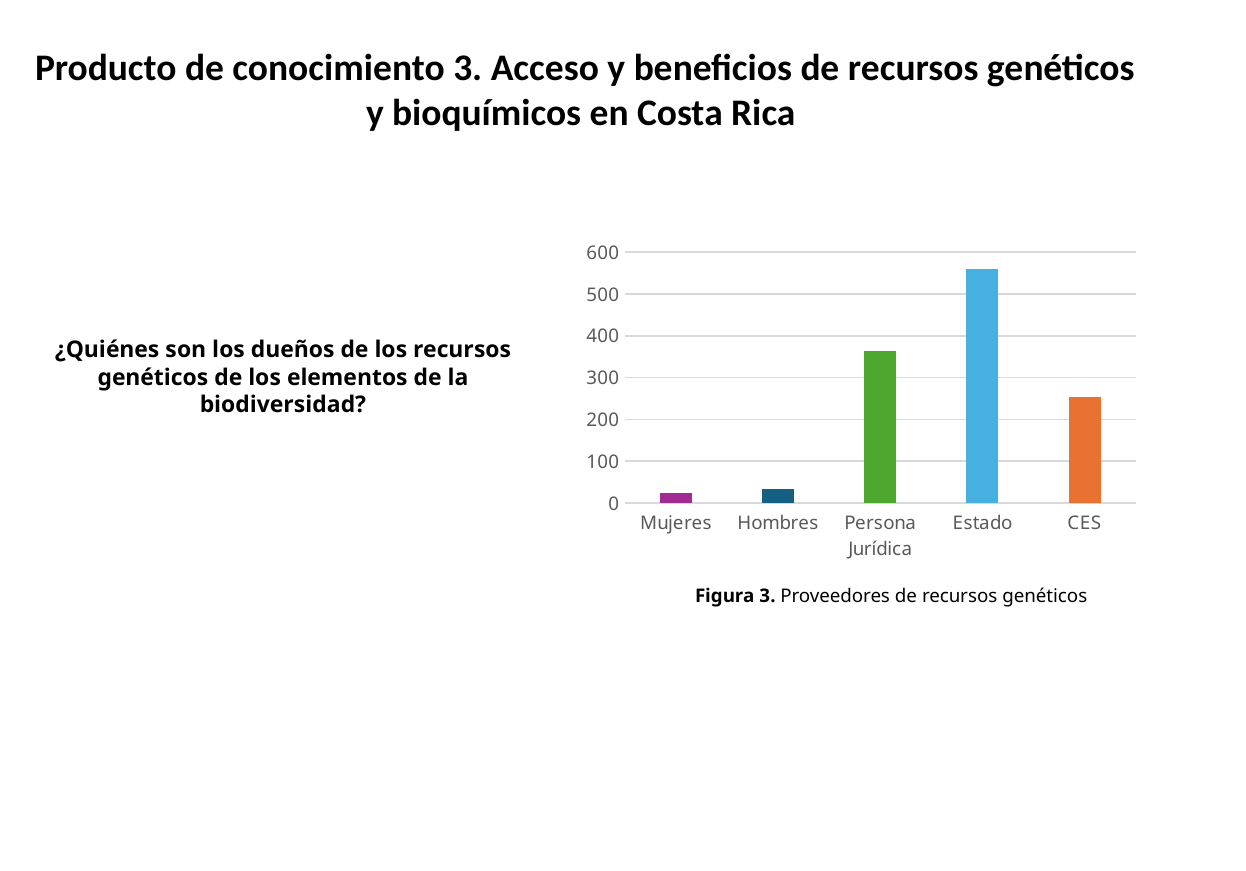
Is the value for Hombres greater or less than 100? less What kind of chart is shown on the slide? bar chart How many categories are shown on the x axis of the chart? 5 Which is larger, the value for Persona Jurídica or the value for CES? Persona Jurídica What is the caption of the figure below the chart? Figura 3. Proveedores de recursos genéticos Which is larger, the value for Estado or the value for Persona Jurídica? Estado Which category has the lowest value in the chart? Mujeres Is the value for Estado greater or less than 500? greater What is the highest value shown on the y axis of the chart? 600 Is the value for CES greater or less than 300? less Which category has the highest value in the chart? Estado